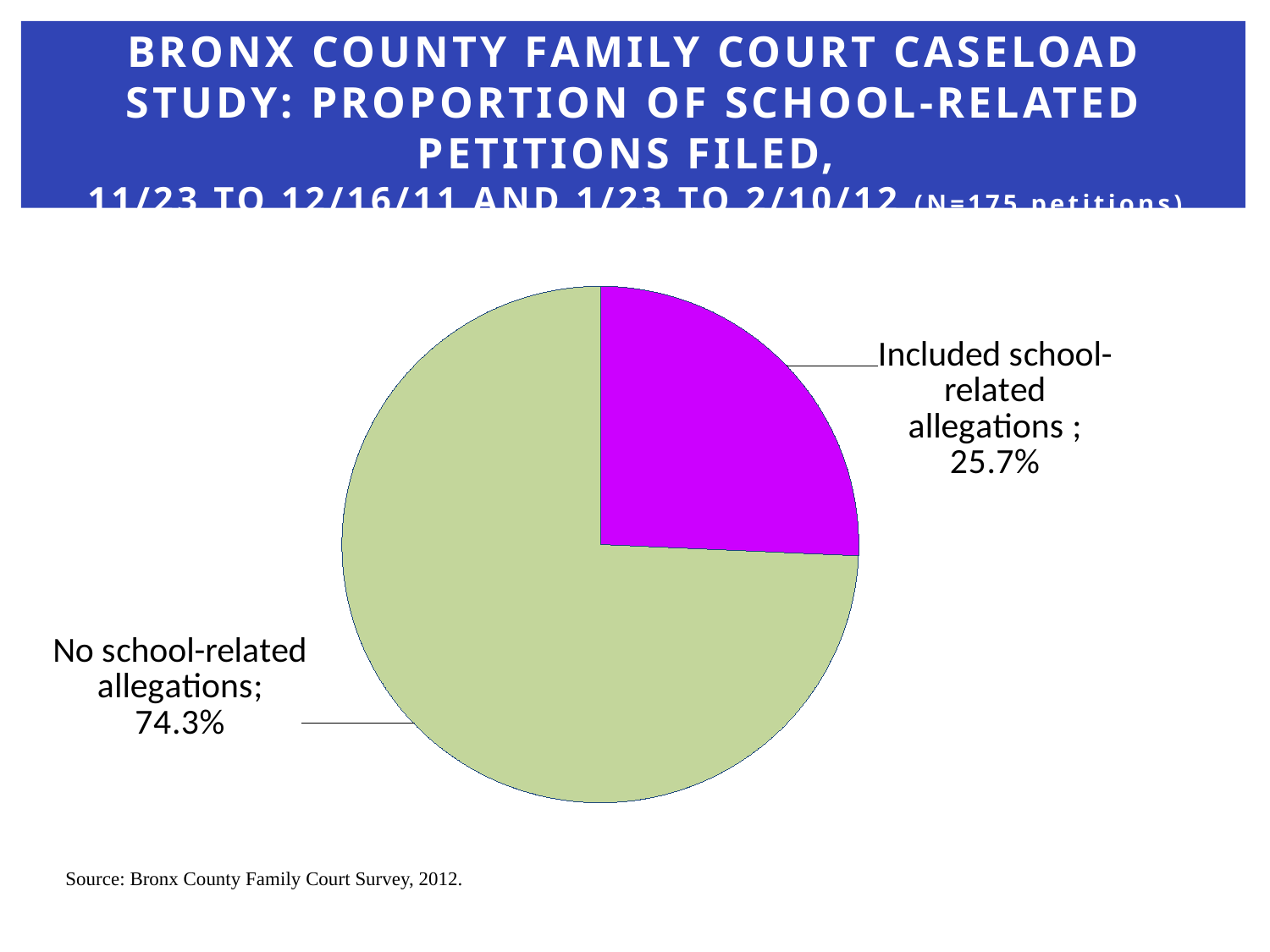
How many petitions does the slide title say were included in the study? 175 What colour is the slice for petitions that included school-related allegations? magenta Which is larger: the share of petitions with no school-related allegations or the share that included school-related allegations? No school-related allegations What is the difference in percentage points between the 'No school-related allegations' slice and the 'Included school-related allegations' slice? 48.6 Which slice of the pie is the smallest? Included school-related allegations What share of petitions included school-related allegations? 25.7% What kind of chart is shown on the slide? pie chart What share of petitions had no school-related allegations? 74.3% Is the share of petitions that included school-related allegations greater or less than 50%? less Which slice of the pie is the largest? No school-related allegations How many slices does the pie chart have? 2